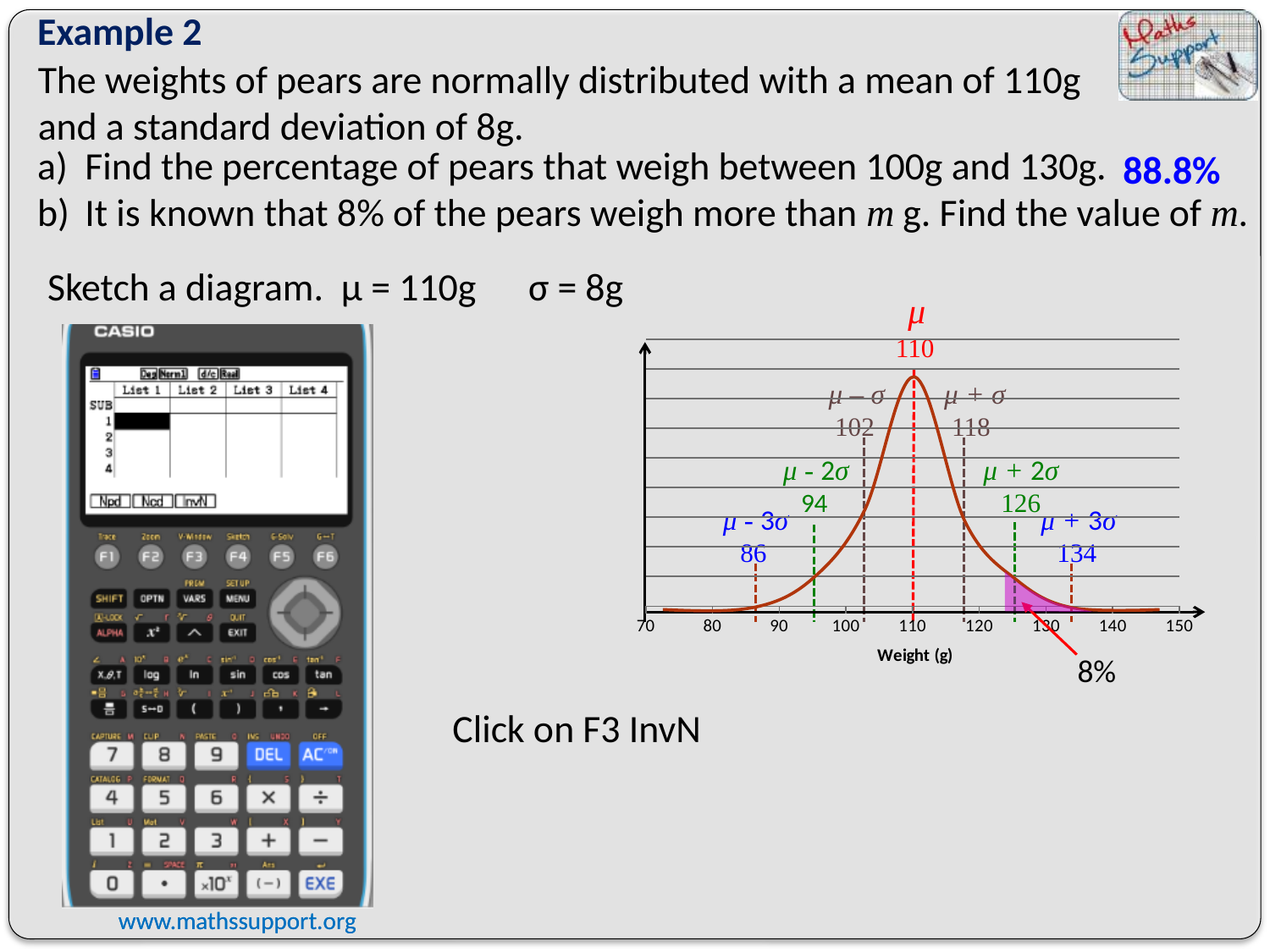
On the normal distribution sketch, what weight value is labelled at the mean μ? 110 How many numbered tick marks are shown on the horizontal axis of the normal distribution sketch? 9 On the normal distribution sketch, what weight value is labelled at μ − 2σ? 94 On the normal distribution sketch, what weight value is labelled at μ + 3σ? 134 What is the highest value shown on the horizontal axis of the normal distribution sketch? 150 On the normal distribution sketch, what weight value is labelled at μ − 3σ? 86 What kind of chart is the sketch on the right of the slide? Line chart (normal distribution curve) What is the label on the horizontal axis of the normal distribution sketch? Weight (g) On the normal distribution sketch, which is larger, the value labelled at μ + 2σ or the value labelled at μ + σ? μ + 2σ (126) On the normal distribution sketch, what weight value is labelled at μ + σ? 118 On the normal distribution sketch, what percentage is the shaded region in the right tail labelled as? 8% On the normal distribution sketch, what is the difference between the values labelled at μ + σ and μ − σ? 16